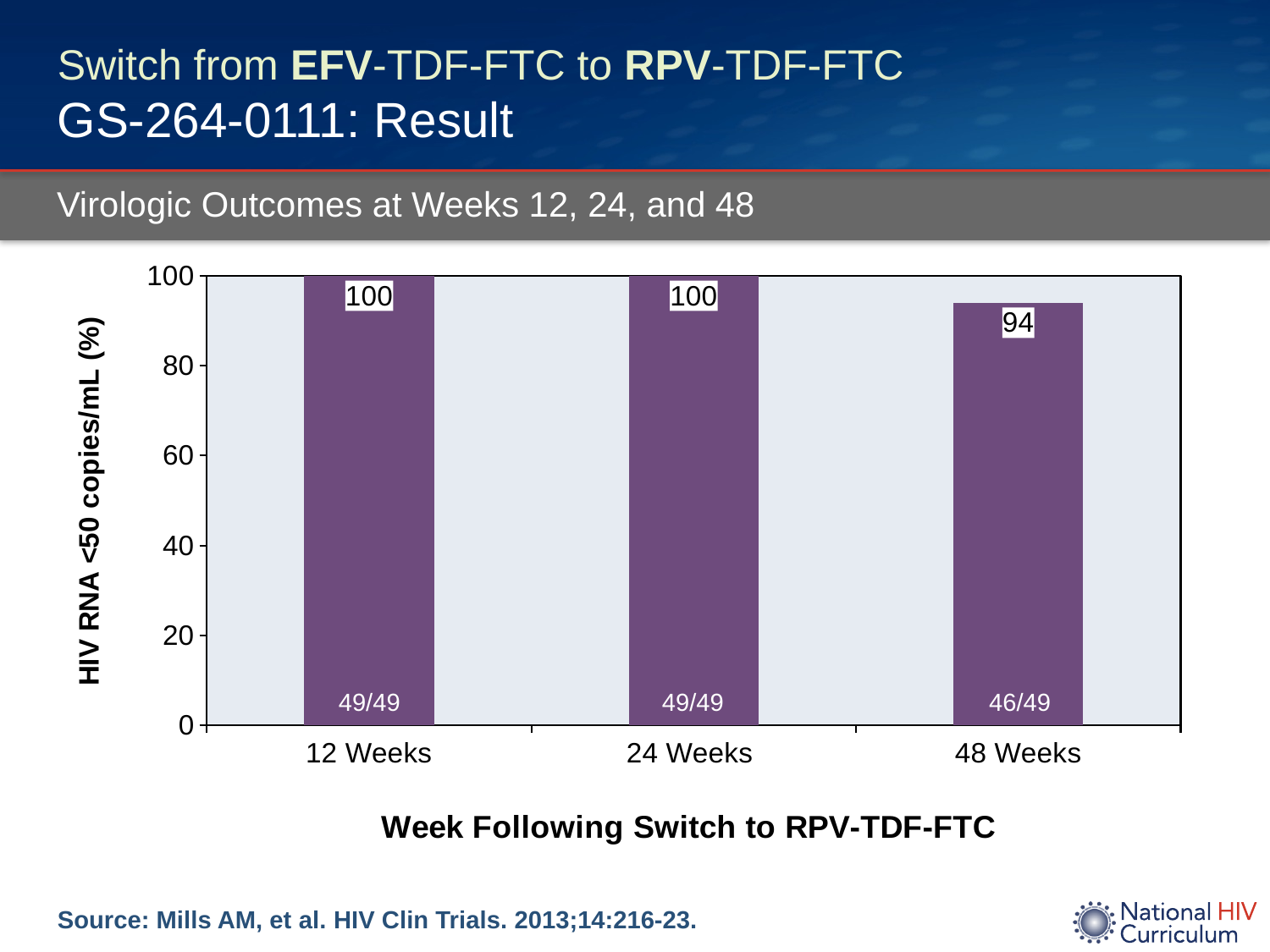
What kind of chart is shown on the slide? bar chart Which is larger, the value for 12 Weeks or the value for 48 Weeks? 12 Weeks How many categories are shown on the x axis? 3 What is the value for 48 Weeks? 94 What is the difference between the values for 24 Weeks and 48 Weeks? 6 What fraction of participants is printed inside the 48 Weeks bar? 46/49 What is the label of the y axis? HIV RNA <50 copies/mL (%) What is the label of the x axis? Week Following Switch to RPV-TDF-FTC Is the value for 48 Weeks greater or less than 80? greater What is the value for 12 Weeks? 100 What is the value for 24 Weeks? 100 Which category has the lowest value? 48 Weeks